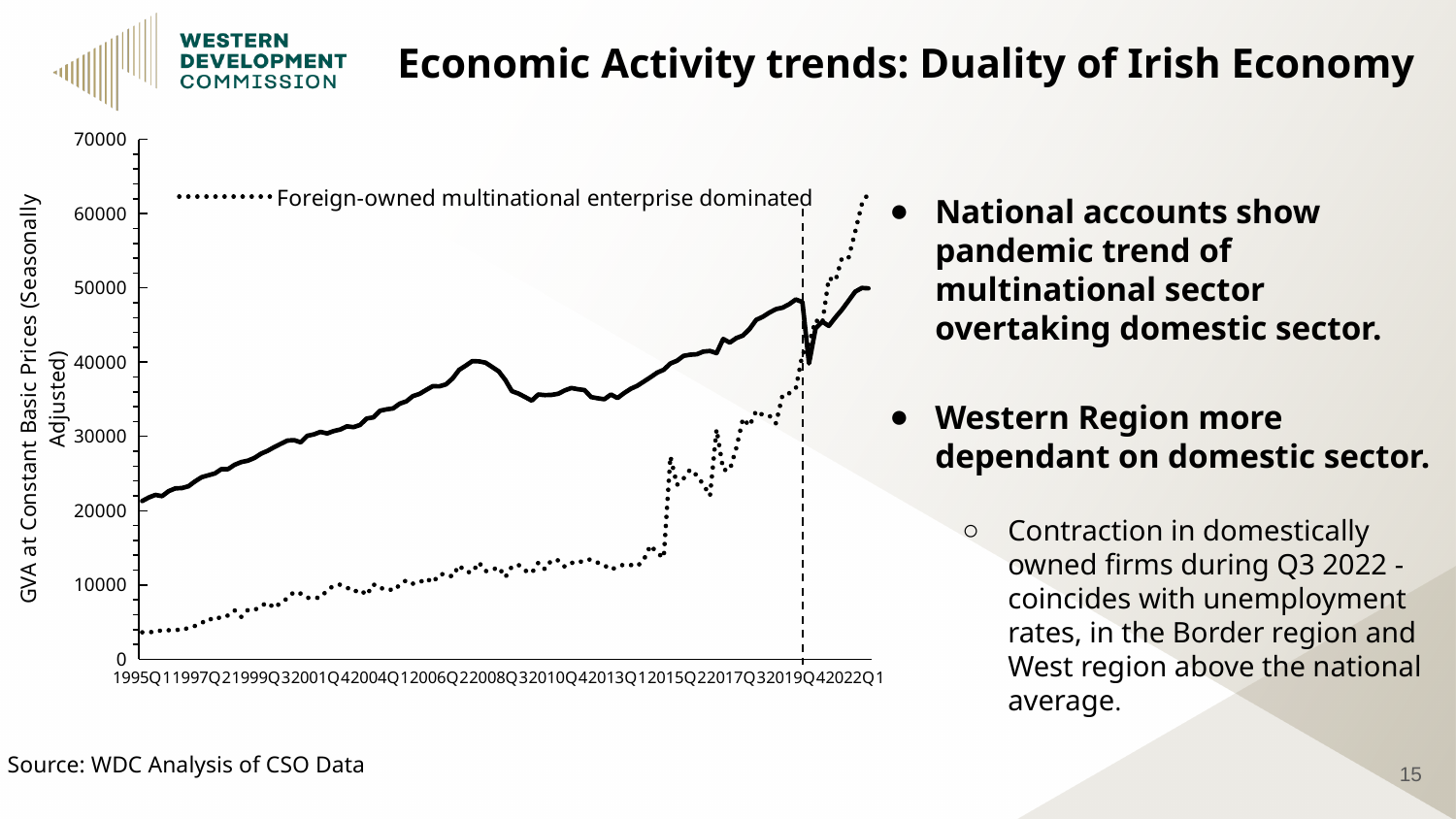
Is the value of the dotted 'Foreign-owned multinational enterprise dominated' line at 1995Q1 greater or less than 10000? less Is the value of the solid line at 2022Q1 greater or less than 60000? less Is the value of the solid line at 1995Q1 greater or less than 10000? greater What is the title of the slide containing the chart? Economic Activity trends: Duality of Irish Economy How many lines are plotted on the chart? 2 Overall, does the dotted 'Foreign-owned multinational enterprise dominated' line rise or fall from 1995Q1 to 2022Q1? Rise What is the label on the vertical axis of the chart? GVA at Constant Basic Prices (Seasonally Adjusted) At 2022Q1, which line has the higher value: the solid line or the dotted 'Foreign-owned multinational enterprise dominated' line? The dotted 'Foreign-owned multinational enterprise dominated' line What kind of chart is shown on the slide? Line chart At 1995Q1, which line has the higher value: the solid line or the dotted 'Foreign-owned multinational enterprise dominated' line? The solid line